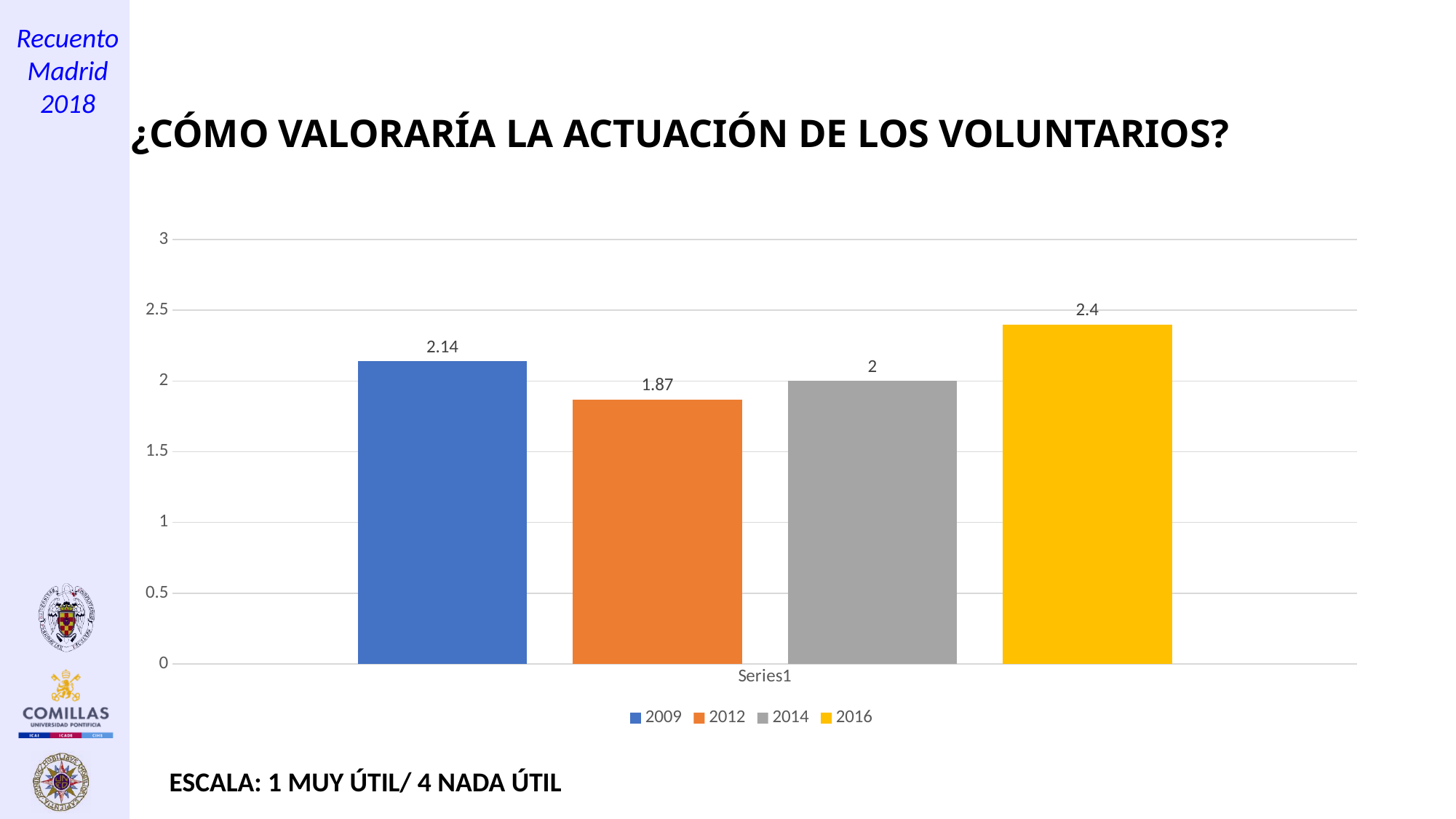
What is the value for 2009? 2.14 What is the value for 2016? 2.4 What colour is the bar for 2016? yellow Which year has the lowest value? 2012 How many series does the legend list? 4 Which is larger, the value for 2009 or the value for 2014? 2009 Which year has the highest value? 2016 What is the difference between the values for 2016 and 2012? 0.53 What is the value for 2014? 2 Is the value for 2012 greater or less than 2? less What kind of chart is shown on the slide? bar chart What is the value for 2012? 1.87